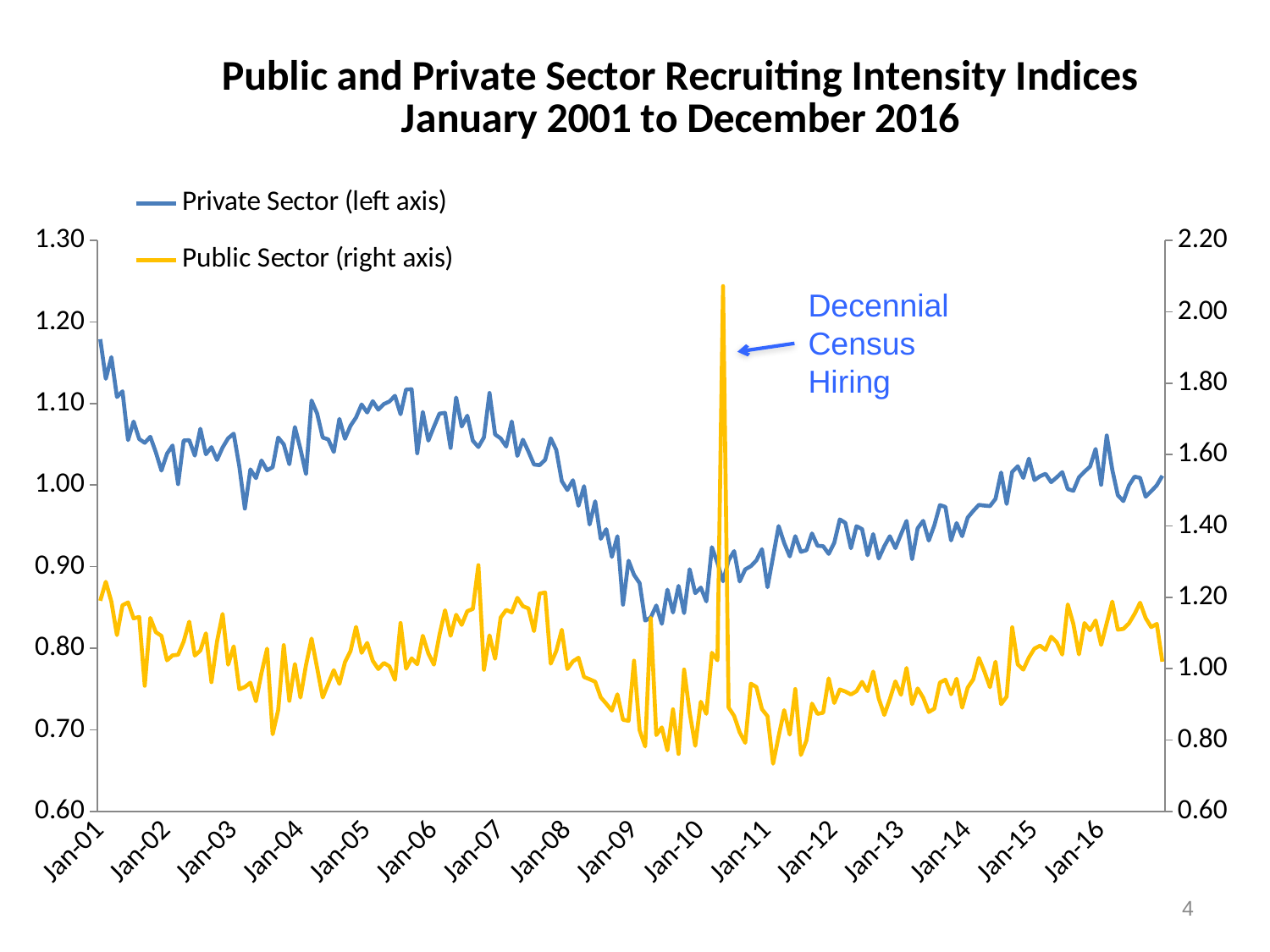
Does the Private Sector series rise or fall between Jan-10 and Jan-15? rise Which series is plotted against the right axis? Public Sector What kind of chart is shown on the slide? Line chart Is the Private Sector value at Jan-09 greater or less than 1.00 on the left axis? less Is the Public Sector value at Jan-11 greater or less than 1.00 on the right axis? less How many series does the legend list? 2 Does the Private Sector series rise or fall between Jan-08 and Jan-09? fall Which series contains the sharp spike that reaches above 2.00 on the right axis? Public Sector What event does the annotation attribute the large spike in the Public Sector series to? Decennial Census Hiring Between which two x-axis labels does the Public Sector spike occur? Jan-10 and Jan-11 Is the Private Sector value at Jan-01 greater or less than 1.10 on the left axis? greater How many year labels are shown on the x axis? 16